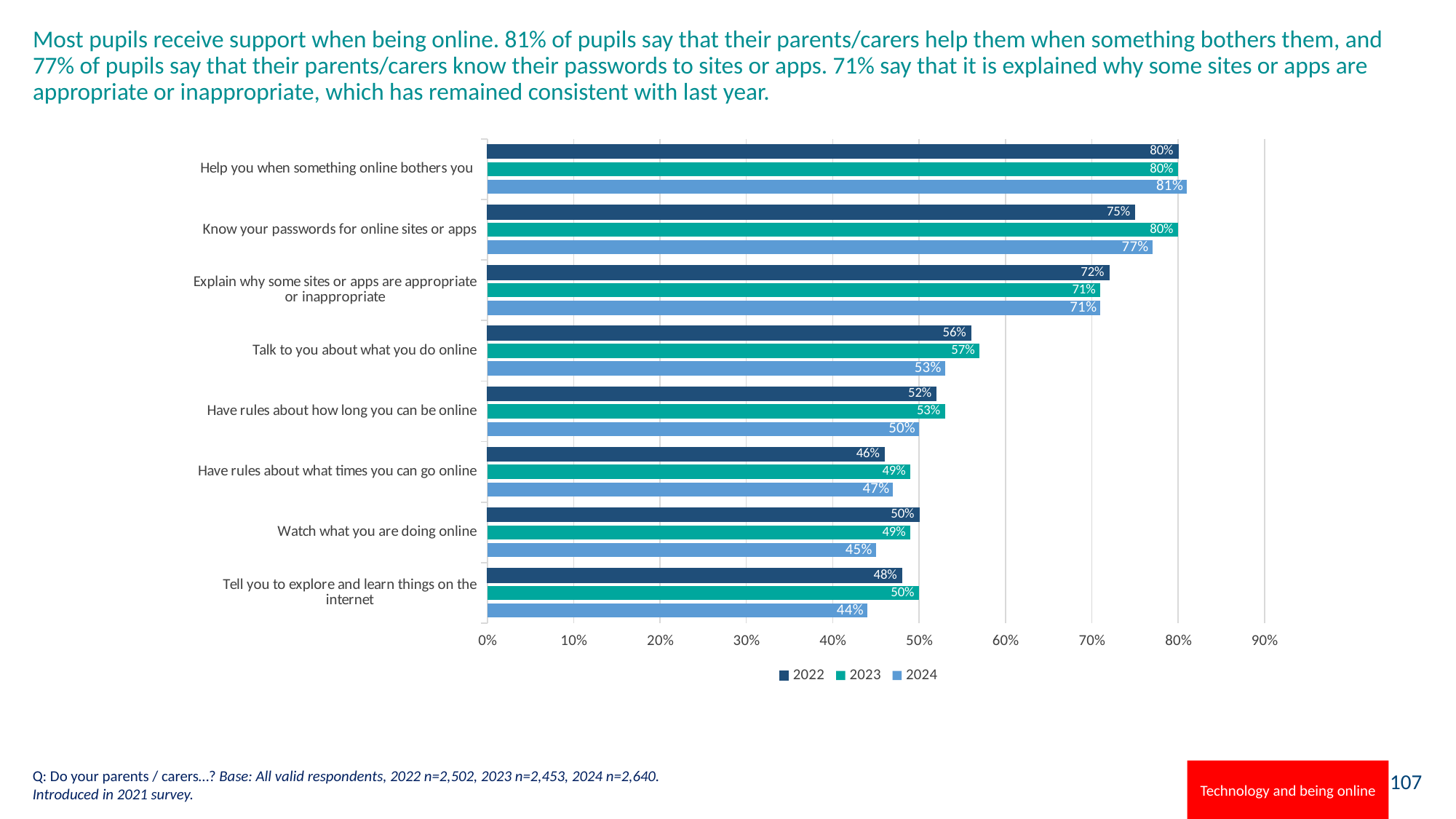
What kind of chart is shown on the slide? Bar chart What is the 2022 value for 'Talk to you about what you do online'? 56% Which is larger for 'Watch what you are doing online': the 2022 value or the 2024 value? 2022 What is the 2024 value for 'Help you when something online bothers you'? 81% Which category has the lowest 2024 value? Tell you to explore and learn things on the internet How many series does the legend list? 3 What is the difference between the 2023 and 2024 values for 'Tell you to explore and learn things on the internet'? 6% Which years are listed in the chart legend? 2022, 2023, 2024 How many categories are shown on the chart? 8 Which category has the highest 2024 value? Help you when something online bothers you What is the 2024 value for 'Tell you to explore and learn things on the internet'? 44% What is the 2023 value for 'Know your passwords for online sites or apps'? 80%